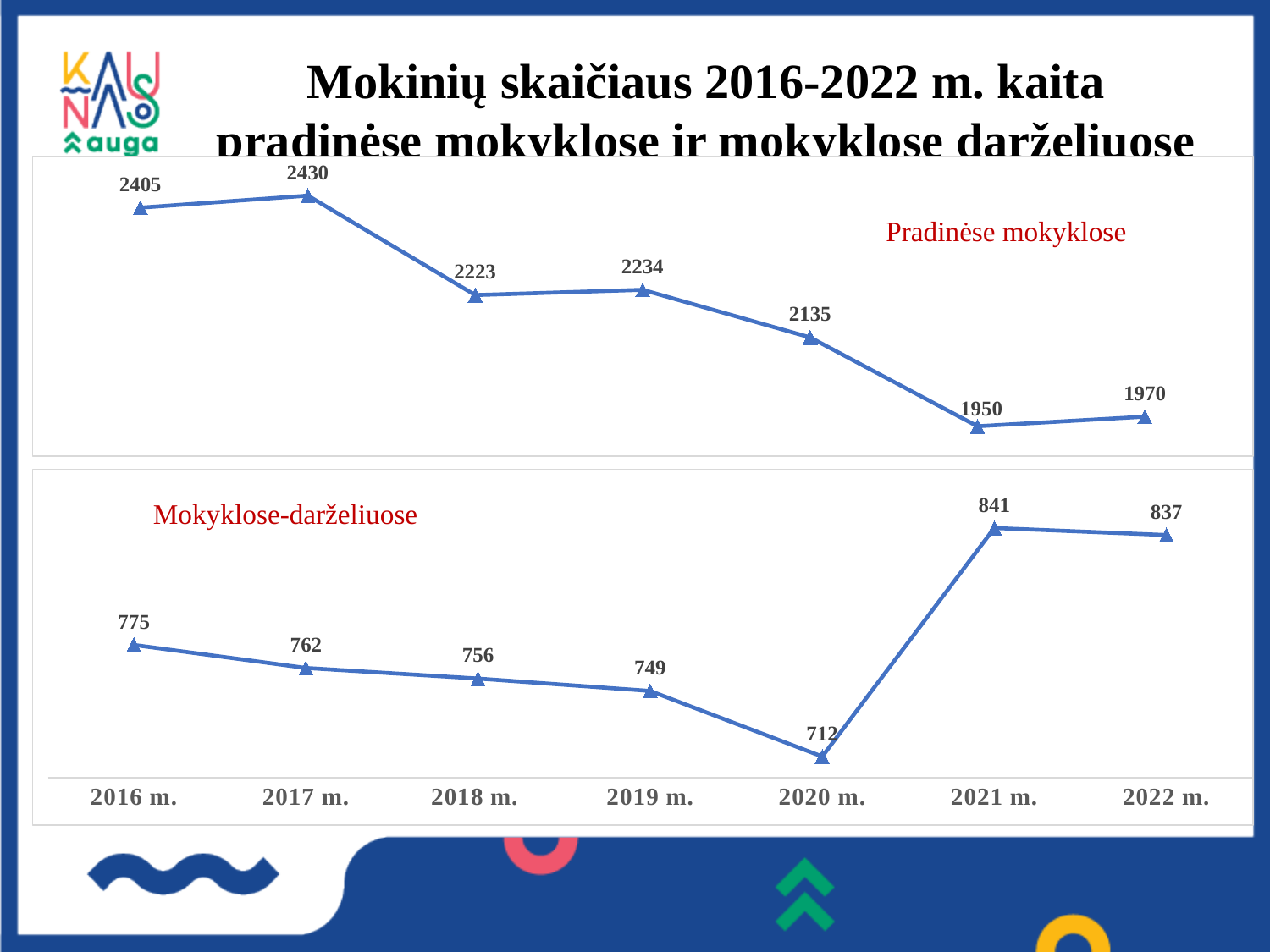
In the 'Pradinėse mokyklose' chart, which year has the lowest value? 2021 m. In the 'Mokyklose-darželiuose' chart, what is the value for 2021 m.? 841 In the 'Pradinėse mokyklose' chart, what is the value for 2017 m.? 2430 In the 'Mokyklose-darželiuose' chart, what is the difference between the 2021 m. and 2020 m. values? 129 In the 'Pradinėse mokyklose' chart, how many data points are plotted? 7 In the 'Mokyklose-darželiuose' chart, which is larger, the value for 2016 m. or the value for 2019 m.? 2016 m. In the 'Mokyklose-darželiuose' chart, what is the value for 2020 m.? 712 What type of chart is the 'Pradinėse mokyklose' chart? line chart In the 'Mokyklose-darželiuose' chart, which year has the highest value? 2021 m. In the 'Mokyklose-darželiuose' chart, do the values rise or fall from 2016 m. to 2020 m.? fall In the 'Pradinėse mokyklose' chart, what is the difference between the 2016 m. and 2022 m. values? 435 In the 'Pradinėse mokyklose' chart, what is the value for 2020 m.? 2135